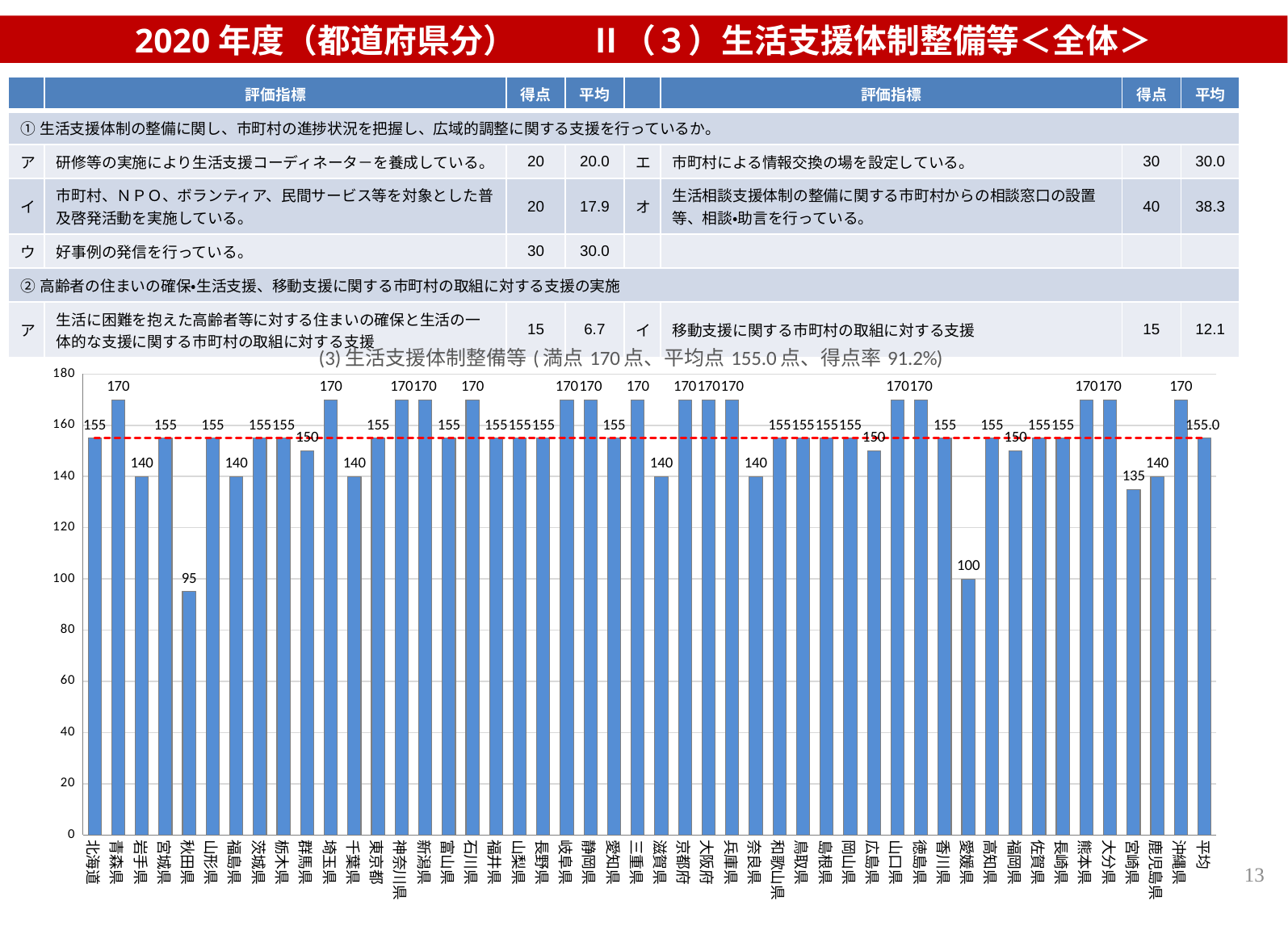
What is the value for 秋田県? 95 Which category has the lowest value? 秋田県 What is the value for 愛媛県? 100 What is the value shown for 平均 (the last bar)? 155.0 What is the difference between the values for 沖縄県 and 鹿児島県? 30 According to the chart title, what is the 満点 (maximum score)? 170点 What kind of chart is shown on the slide? bar chart Which is larger, the value for 群馬県 or the value for 千葉県? 群馬県 How many bars are plotted in the chart? 48 What is the difference between the values for 青森県 and 岩手県? 30 Is the value for 秋田県 greater or less than 100? less What is the value for 宮崎県? 135